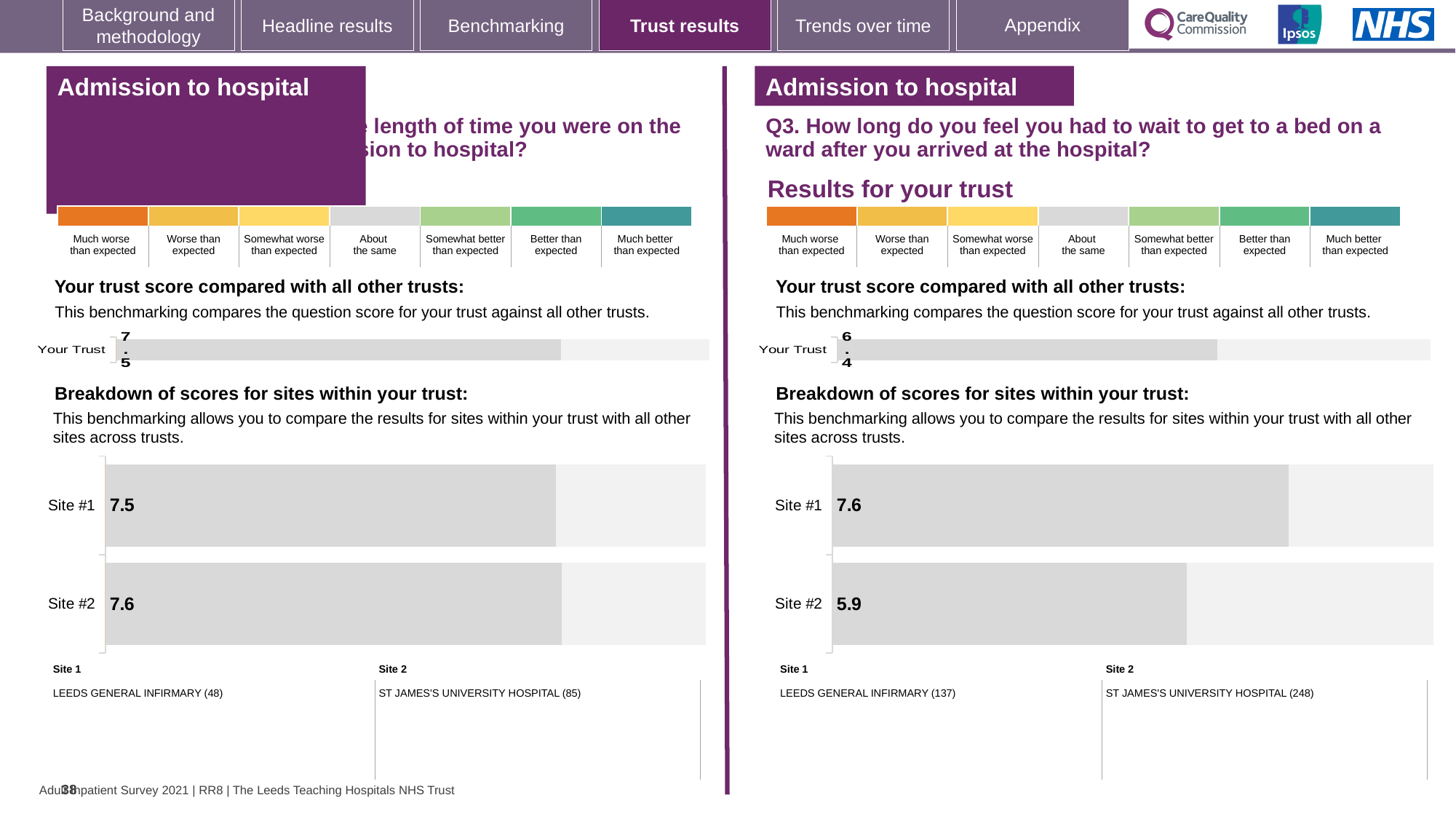
On the right-hand Q3 site breakdown chart, what is the score for Site #1? 7.6 On the right-hand Q3 site breakdown chart, is the Site #2 score larger or smaller than the 'Your Trust' score of 6.4? Smaller On the right-hand Q3 site breakdown chart, what is the score for Site #2? 5.9 On the left-hand chart, what is the 'Your Trust' score? 7.5 On the left-hand site breakdown chart, how many sites are shown? 2 On the right-hand Q3 site breakdown chart, what is the difference between the Site #1 and Site #2 scores? 1.7 On the right-hand chart for Q3 (wait to get to a bed on a ward), what is the 'Your Trust' score? 6.4 On the right-hand Q3 site breakdown chart, which site has the higher score? Site #1 On the right-hand side of the slide, which hospital is listed as Site 2? ST JAMES'S UNIVERSITY HOSPITAL (248) On the left-hand site breakdown chart, what is the difference between the Site #2 and Site #1 scores? 0.1 What type of chart is used for the site breakdown on the right-hand side of the slide? Bar chart On the left-hand site breakdown chart, what is the score for Site #2? 7.6